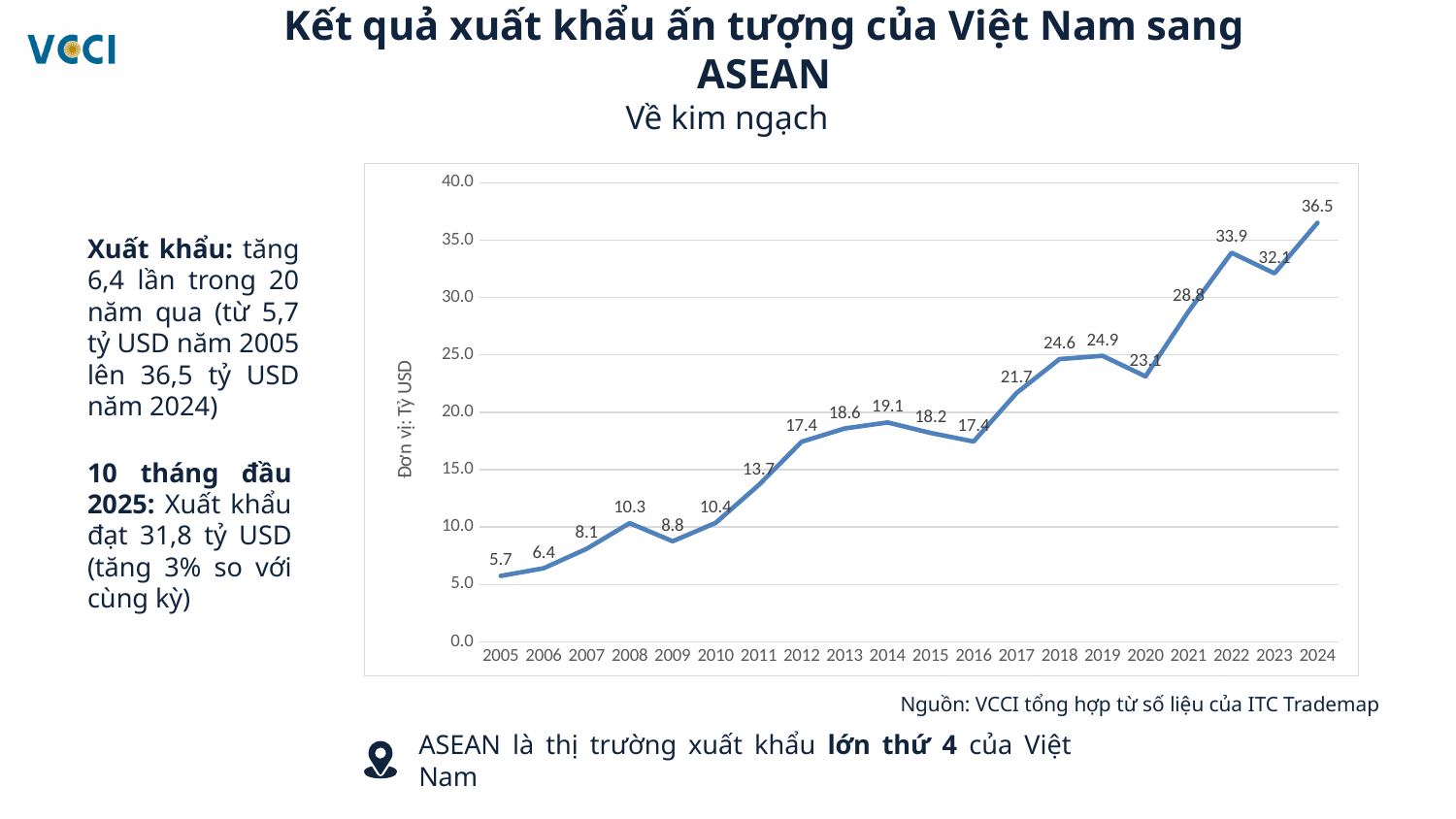
What unit is given on the y axis label? Tỷ USD What is the difference between the values for 2024 and 2023? 4.4 What is the value for 2005? 5.7 How many years are plotted on the x axis? 20 Which is larger, the value for 2014 or the value for 2016? 2014 Is the value for 2021 greater or less than 25.0? greater What is the value for 2024? 36.5 What kind of chart is shown? line chart What is the value for 2020? 23.1 What is the difference between the values for 2022 and 2021? 5.1 Which year has the highest value? 2024 Which year has the lowest value? 2005